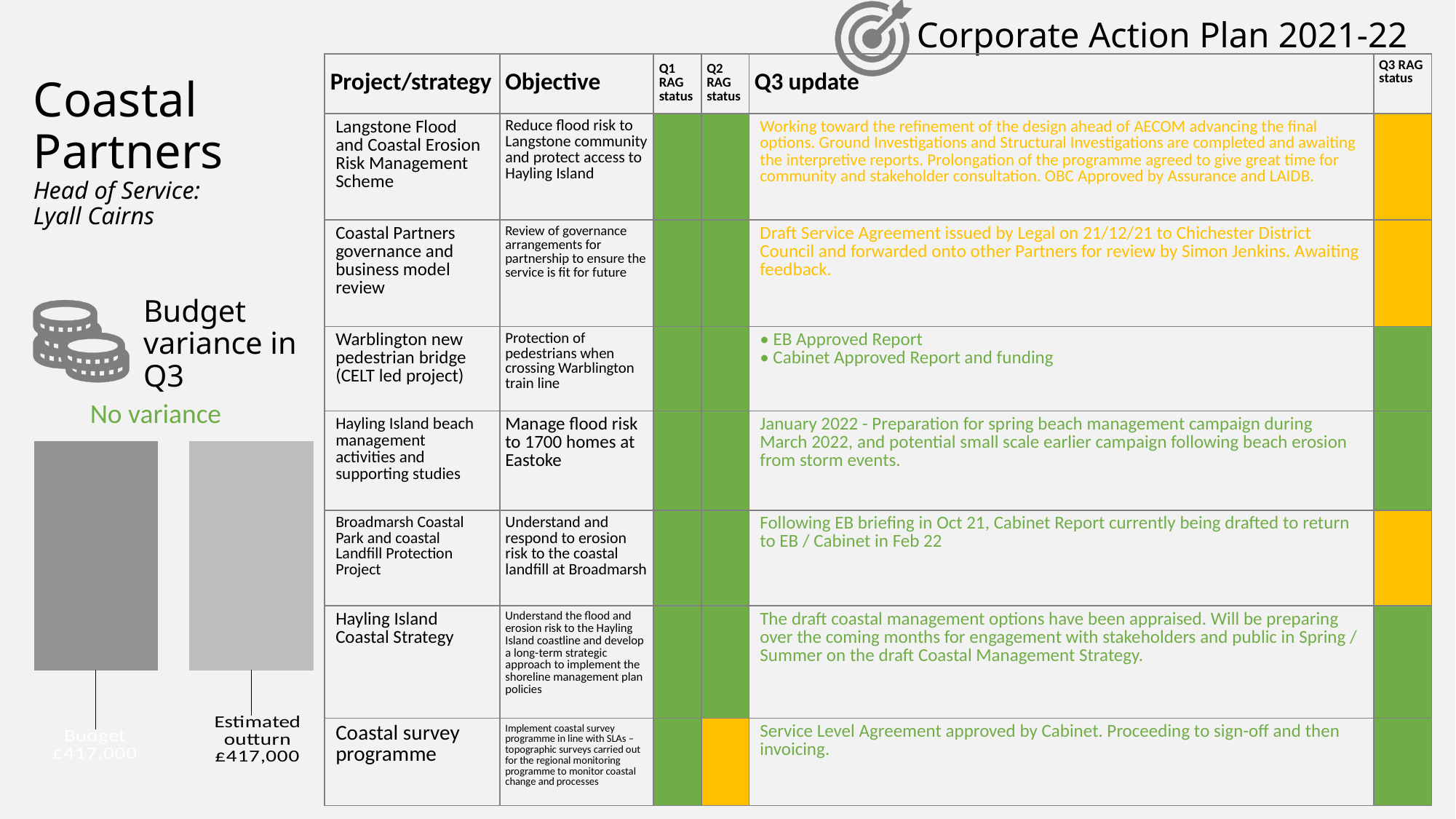
In the Budget variance in Q3 chart, is the Budget value larger than, smaller than, or equal to the Estimated outturn value? Equal How many bars are plotted in the Budget variance in Q3 chart? 2 What is the value of the Estimated outturn bar in the Budget variance in Q3 chart? £417,000 What text is shown in green directly above the Budget variance in Q3 chart? No variance What are the two category labels on the Budget variance in Q3 chart? Budget and Estimated outturn What is the value of the Budget bar in the Budget variance in Q3 chart? £417,000 What is the difference between the Budget and the Estimated outturn in the Budget variance in Q3 chart? £0 What kind of chart is used to show the budget variance in Q3? Bar chart